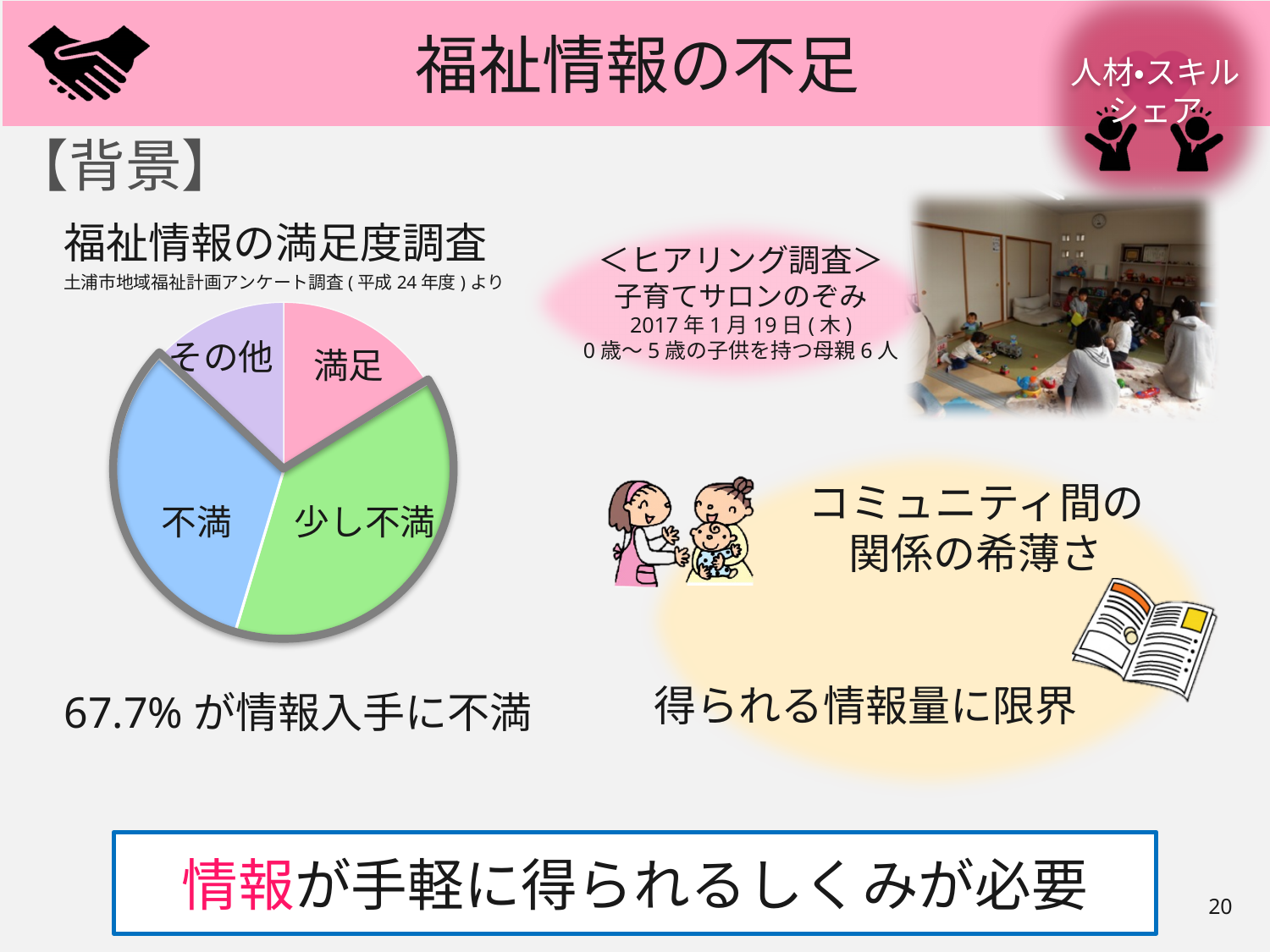
In the pie chart 福祉情報の満足度調査, what colour is the 不満 slice? blue What is the title of the pie chart on the slide? 福祉情報の満足度調査 In the pie chart 福祉情報の満足度調査, which slice is larger: 不満 or 満足? 不満 In the pie chart 福祉情報の満足度調査, which slice is larger: 少し不満 or 満足? 少し不満 What kind of chart is shown under the heading 福祉情報の満足度調査? pie chart In the pie chart 福祉情報の満足度調査, which slice is larger: 不満 or その他? 不満 How many slices does the pie chart 福祉情報の満足度調査 have? 4